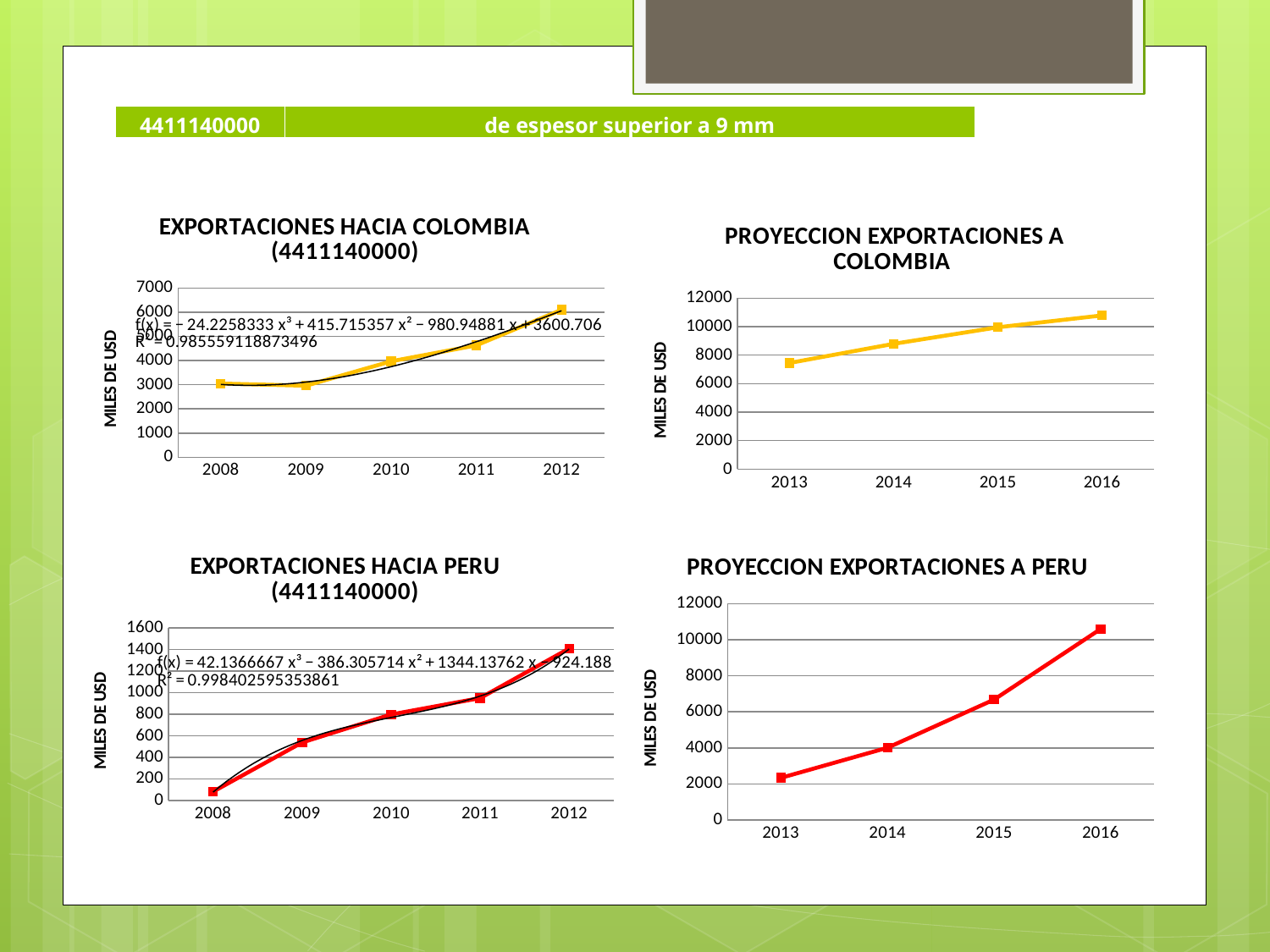
In the 'PROYECCION EXPORTACIONES A PERU' chart, is the value for 2013 greater or less than 4000? less In the 'EXPORTACIONES HACIA COLOMBIA (4411140000)' chart, is the value for 2012 greater or less than 5000? greater How many years are plotted on the x axis of the 'PROYECCION EXPORTACIONES A COLOMBIA' chart? 4 In the 'PROYECCION EXPORTACIONES A PERU' chart, which is larger, the value for 2014 or the value for 2016? 2016 What kind of chart is the 'EXPORTACIONES HACIA COLOMBIA (4411140000)' chart? line chart What is the y-axis label of the 'PROYECCION EXPORTACIONES A PERU' chart? MILES DE USD In the 'EXPORTACIONES HACIA PERU (4411140000)' chart, is the value for 2012 greater or less than 1200? greater In the 'PROYECCION EXPORTACIONES A COLOMBIA' chart, do the values rise or fall from 2013 to 2016? rise In the 'EXPORTACIONES HACIA COLOMBIA (4411140000)' chart, which year has the highest value? 2012 In the 'EXPORTACIONES HACIA PERU (4411140000)' chart, which year has the lowest value? 2008